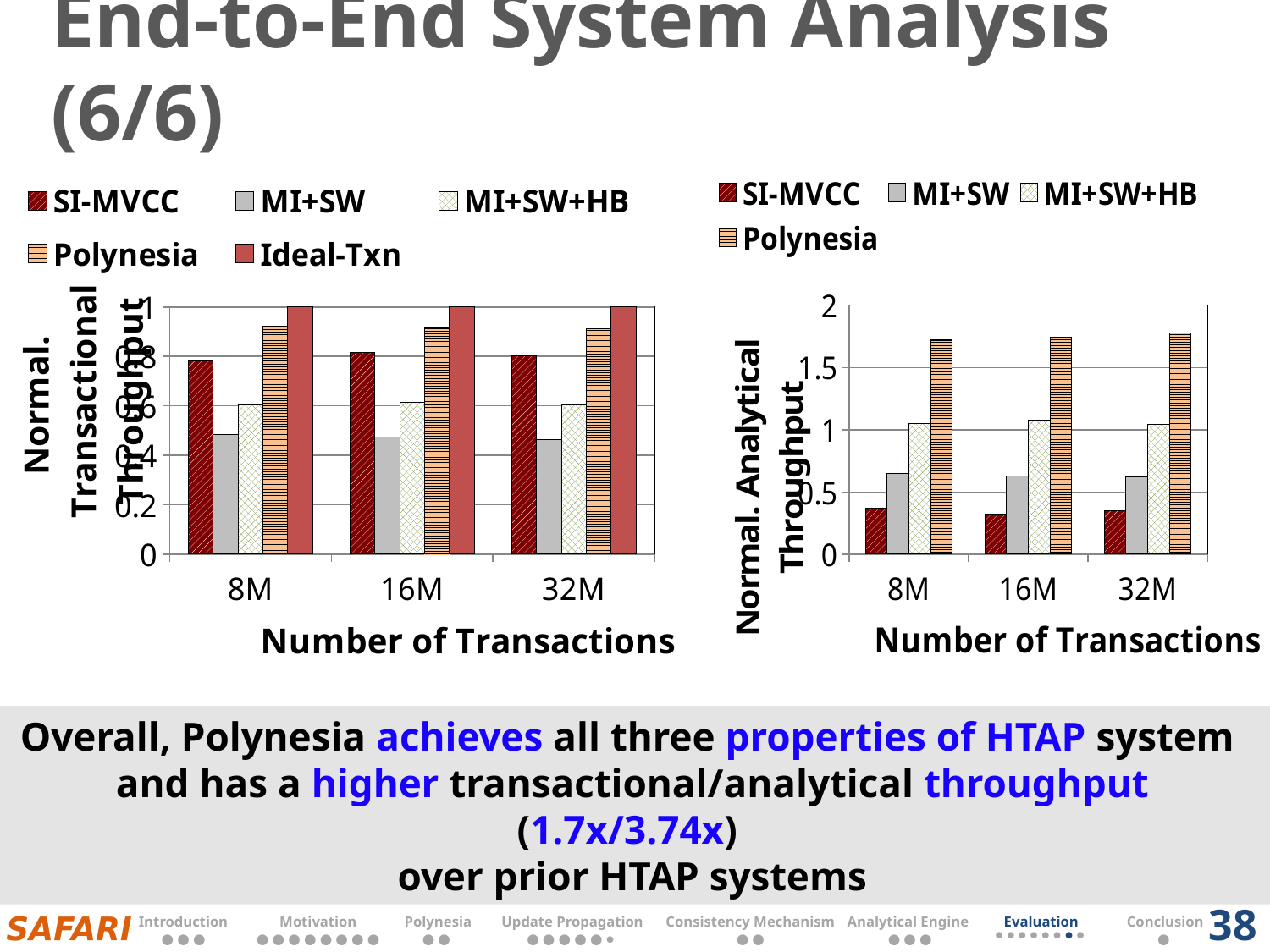
In the right chart (Normal. Analytical Throughput), which series has the lowest value at 32M? SI-MVCC In the left chart (Normal. Transactional Throughput), is the value for SI-MVCC at 8M greater or less than 0.6? greater In the left chart (Normal. Transactional Throughput), which is larger at 16M: SI-MVCC or MI+SW+HB? SI-MVCC In the right chart (Normal. Analytical Throughput), which series has the highest value at 16M? Polynesia How many series does the legend of the left chart (Normal. Transactional Throughput) list? 5 How many categories are shown on the x axis of the right chart (Normal. Analytical Throughput)? 3 In the left chart (Normal. Transactional Throughput), which series has the lowest value at 8M? MI+SW In the left chart (Normal. Transactional Throughput), what is the value of Ideal-Txn at 8M? 1 In the right chart (Normal. Analytical Throughput), is the value for Polynesia at 8M greater or less than 1.5? greater What type of chart is the left chart (Normal. Transactional Throughput)? bar chart In the right chart (Normal. Analytical Throughput), is the value for SI-MVCC at 16M greater or less than 0.5? less How many series does the legend of the right chart (Normal. Analytical Throughput) list? 4